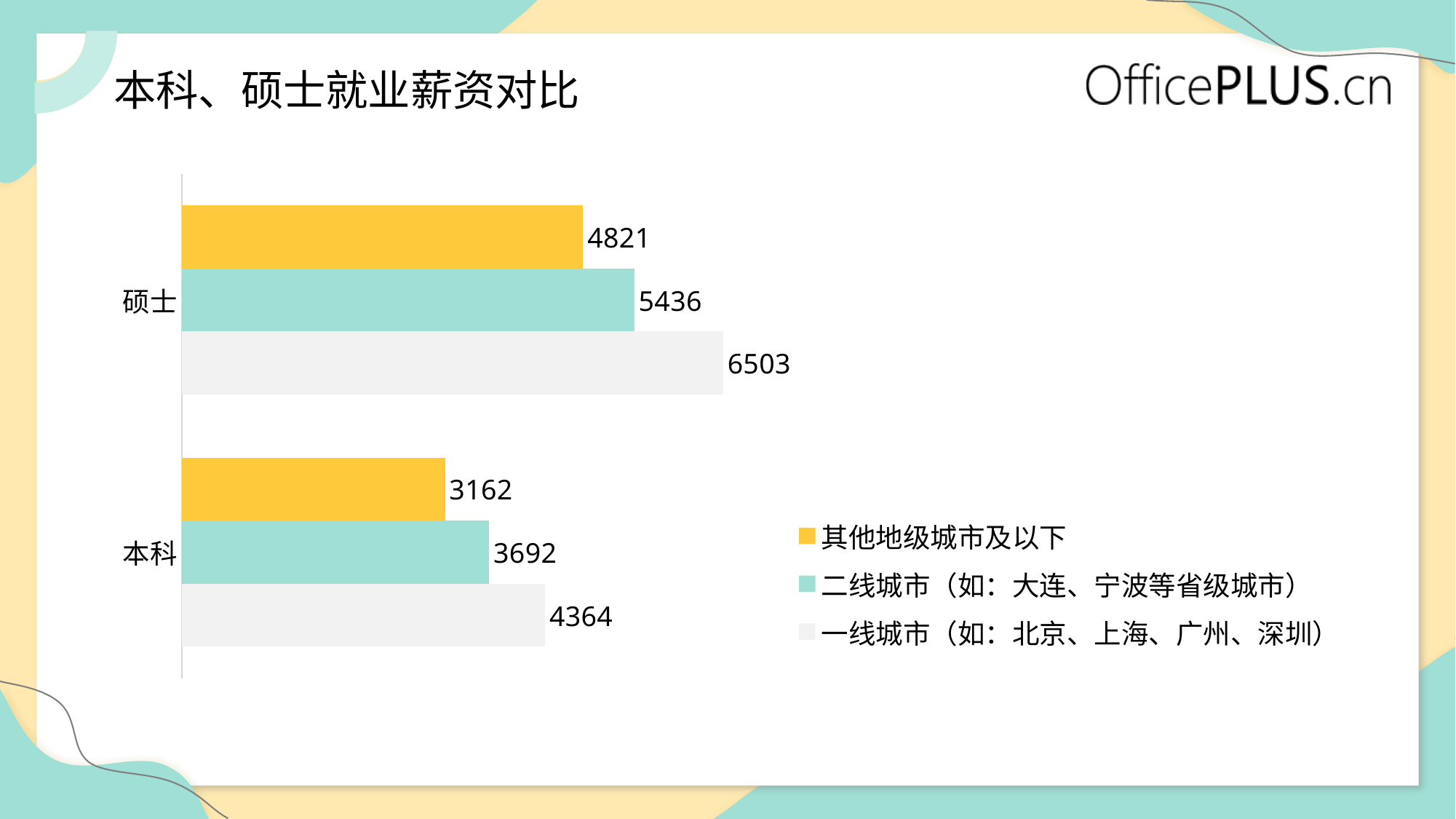
How many categories are shown on the chart? 2 How many series does the legend list? 3 What is the difference between the 一线城市 values for 硕士 and 本科? 2139 What is the value for 硕士 in the 二线城市 series? 5436 Which series has the lowest value for 本科? 其他地级城市及以下 What is the value for 本科 in the 其他地级城市及以下 series? 3162 Which category has the highest value in the 二线城市 series? 硕士 Which is larger: the 其他地级城市及以下 value for 硕士 or the 一线城市 value for 本科? 其他地级城市及以下 value for 硕士 What is the value for 硕士 in the 一线城市 series? 6503 What is the value for 本科 in the 一线城市 series? 4364 What is the difference between the 二线城市 and 其他地级城市及以下 values for 硕士? 615 What kind of chart is shown on the slide? Bar chart